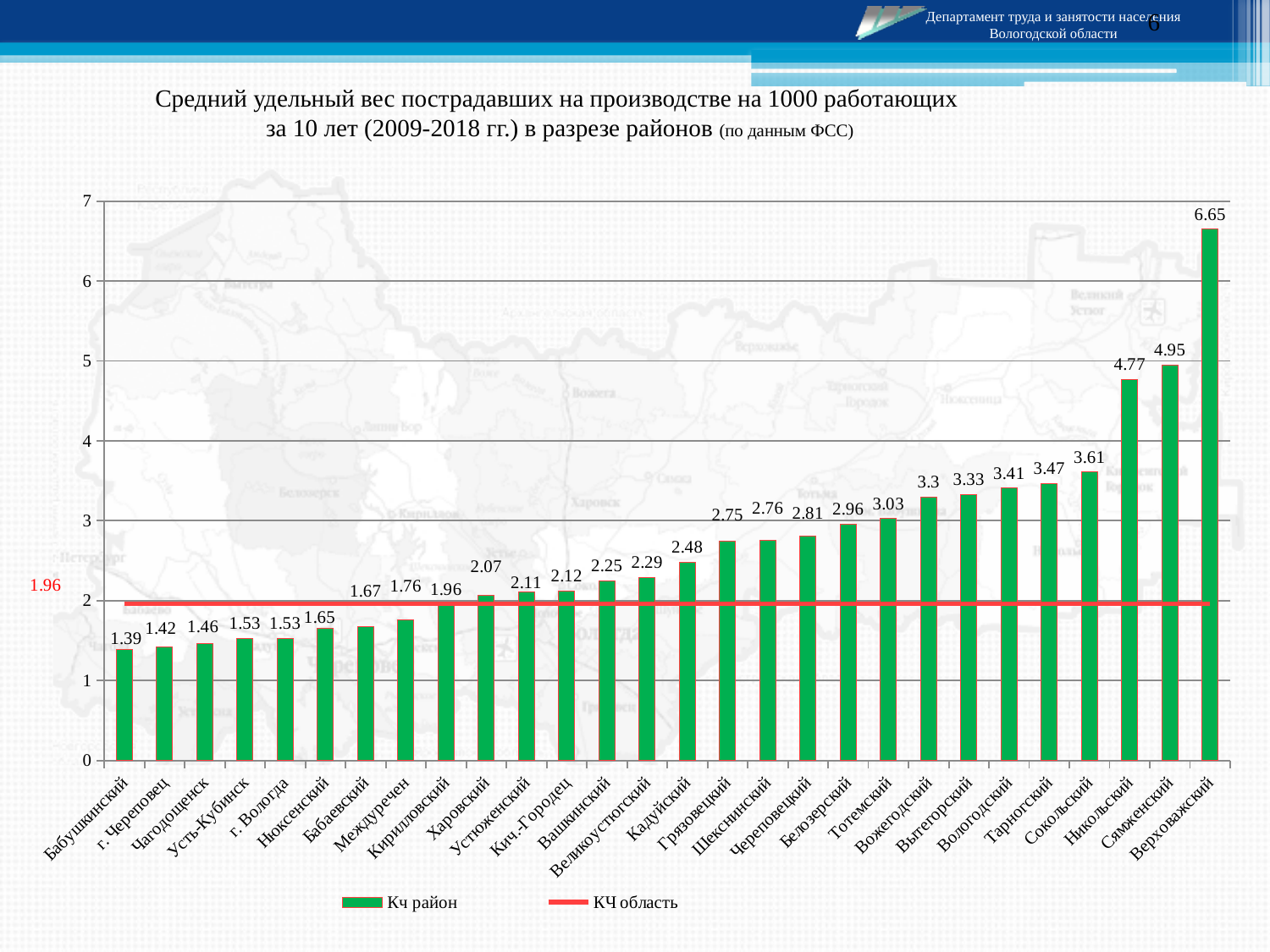
Which district has the highest value? Верховажский What is the value for Тотемский? 3.03 What kind of chart is this? bar chart Which has a larger value, Никольский or Сокольский? Никольский What is the value for Бабушкинский? 1.39 What is the value of the red line labelled КЧ область? 1.96 Is the value for Кадуйский greater or less than 3? less What is the difference between the values for Верховажский and Сямженский? 1.7 What is the value for Верховажский? 6.65 How many entries does the legend list? 2 Which district has the lowest value? Бабушкинский How many districts are shown on the x axis? 28